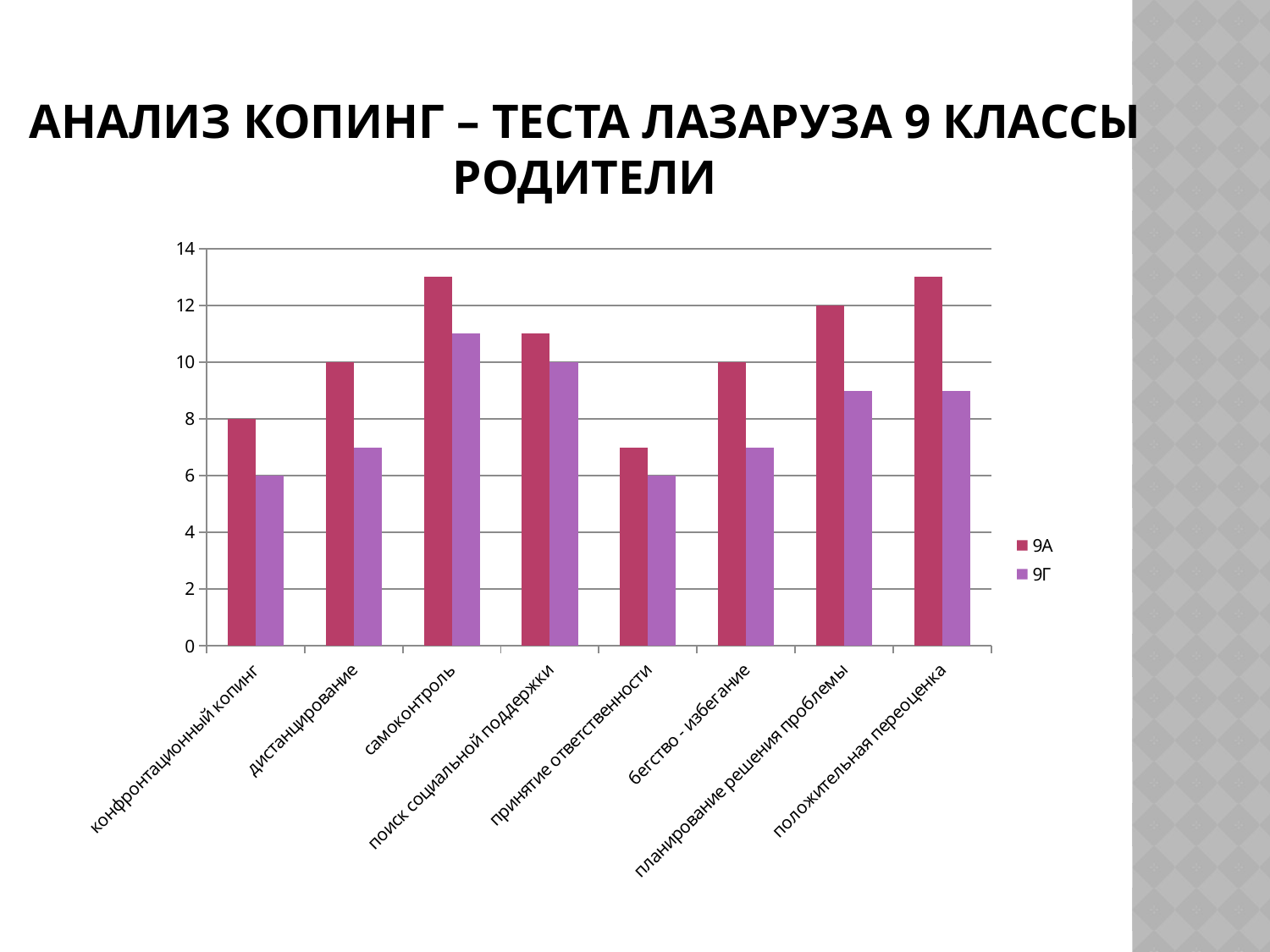
What type of chart is shown on the slide? bar chart What is the value for 9А in the category планирование решения проблемы? 12 What are the two series named in the legend? 9А and 9Г How many series does the legend list? 2 In the category самоконтроль, which series has the larger value, 9А or 9Г? 9А What is the value for 9Г in the category принятие ответственности? 6 Is the value for 9А in самоконтроль greater or less than 12? greater What is the value for 9А in the category конфронтационный копинг? 8 Which category has the highest value for the 9Г series? самоконтроль Which category has the lowest value for the 9А series? принятие ответственности What is the value for 9Г in the category поиск социальной поддержки? 10 How many categories are shown on the x axis? 8